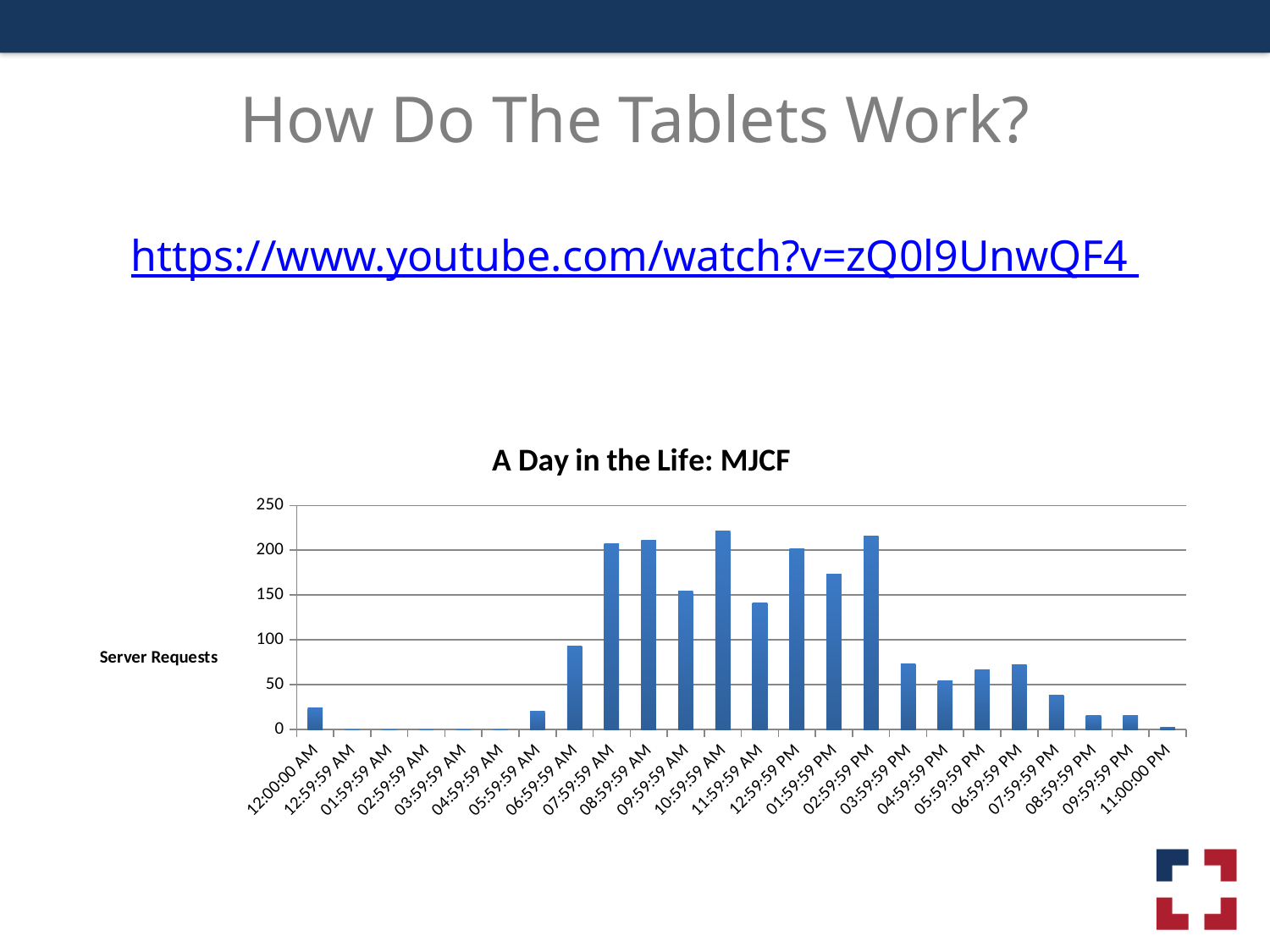
Is the value for 07:59:59 PM greater or less than 50? less Which has more server requests, 11:59:59 AM or 12:59:59 PM? 12:59:59 PM Is the value for 01:59:59 PM greater or less than 150? greater Do the values generally rise or fall from 02:59:59 PM to 11:00:00 PM? fall How many time categories are shown on the x axis of the chart? 24 Is the value for 11:59:59 AM greater or less than 150? less What kind of chart is shown on the slide? bar chart What is the title of the chart? A Day in the Life: MJCF Which has more server requests, 06:59:59 AM or 07:59:59 AM? 07:59:59 AM What is the label on the vertical axis of the chart? Server Requests